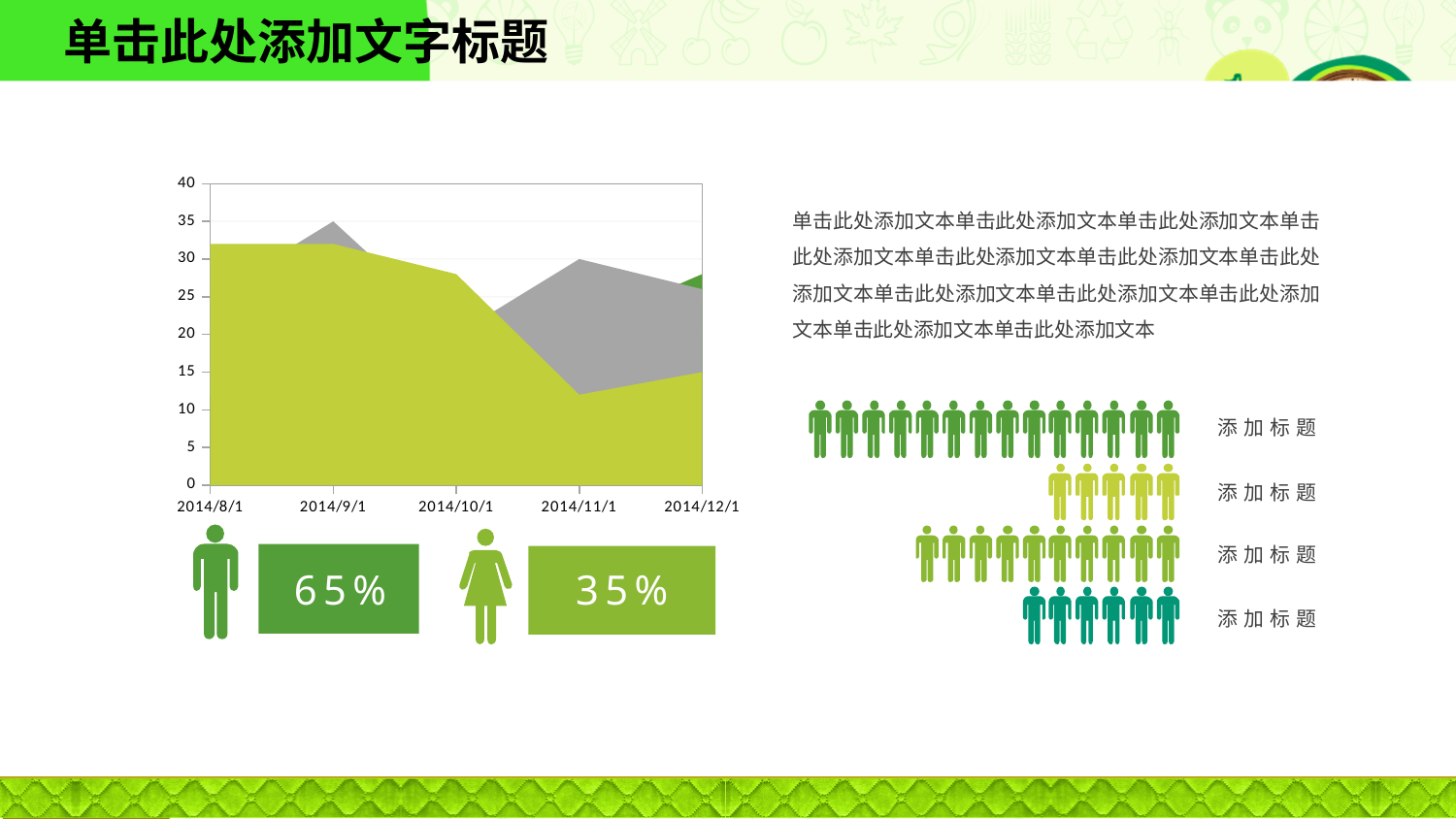
What is the highest value shown on the y axis of the area chart? 40 In the area chart, at 2014/11/1, which series has the larger value, the gray series or the yellow-green series? gray series What is the first date labelled on the x axis of the area chart? 2014/8/1 How many dates are labelled along the x axis of the area chart? 5 In the area chart, is the value of the yellow-green series at 2014/8/1 greater or less than 30? greater In the area chart, is the value of the gray series at 2014/9/1 greater or less than 30? greater In the area chart, is the value of the yellow-green series at 2014/11/1 greater or less than 15? less In the area chart, at which date does the yellow-green series reach its lowest value? 2014/11/1 In the area chart, does the yellow-green series rise or fall from 2014/8/1 to 2014/11/1? fall What kind of chart is shown on the left of the slide? area chart